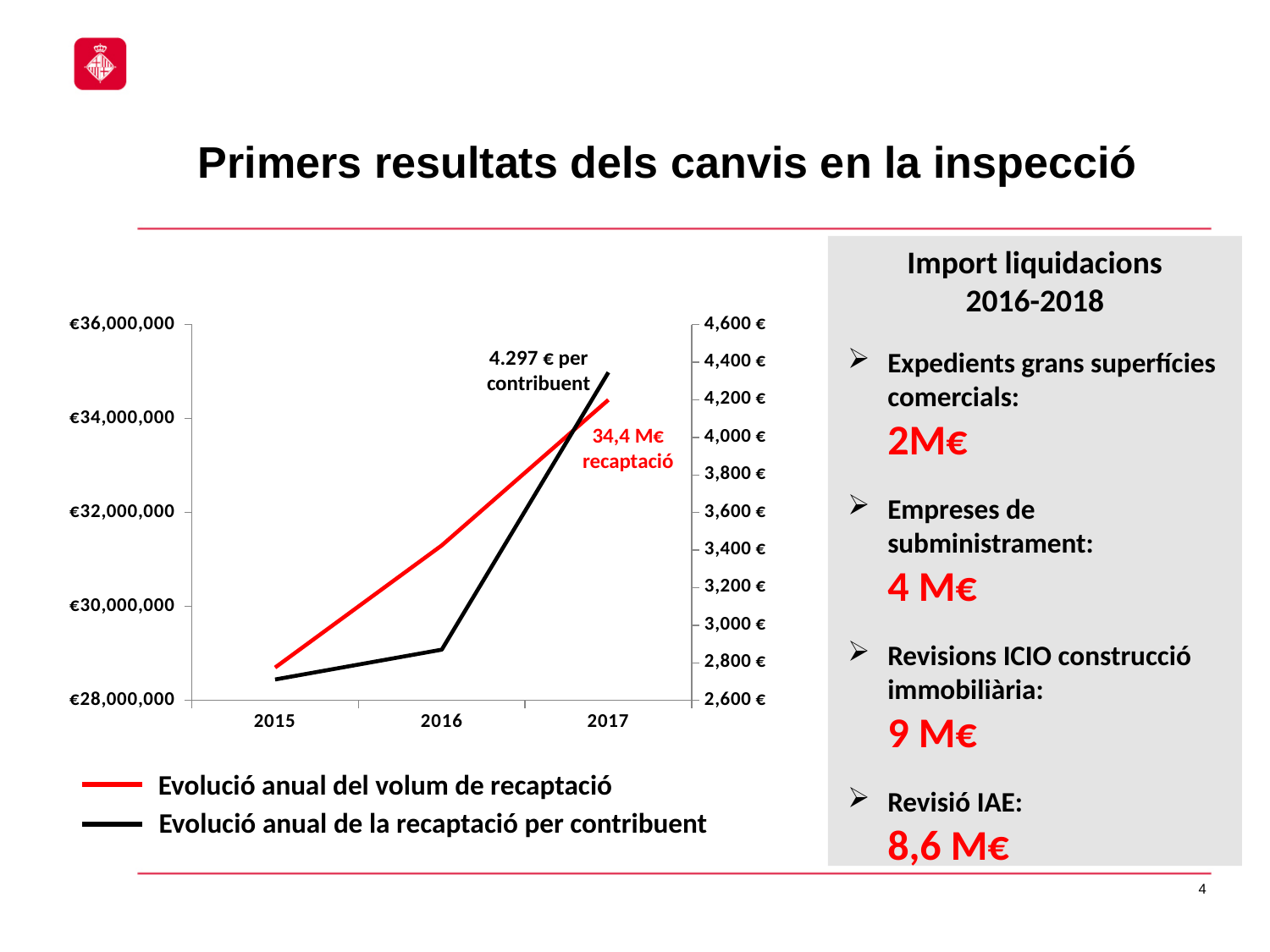
How many series does the chart's legend list? 2 Is the value of 'Evolució anual del volum de recaptació' in 2016 greater or less than €32,000,000? less According to the annotation on the chart, what is the recaptació per contribuent in 2017? 4.297 € According to the annotation on the chart, what is the volume of recaptació in 2017? 34,4 M€ Does the 'Evolució anual del volum de recaptació' line rise or fall from 2015 to 2017? rise In which year is 'Evolució anual del volum de recaptació' at its highest? 2017 Is the value of 'Evolució anual del volum de recaptació' in 2015 greater or less than €30,000,000? less Does the 'Evolució anual de la recaptació per contribuent' line rise or fall from 2015 to 2017? rise Is the value of 'Evolució anual de la recaptació per contribuent' in 2016 greater or less than 3,000 €? less What kind of chart is shown on the slide? line chart How many years are plotted along the x axis of the chart? 3 What colour is the line for 'Evolució anual del volum de recaptació'? red